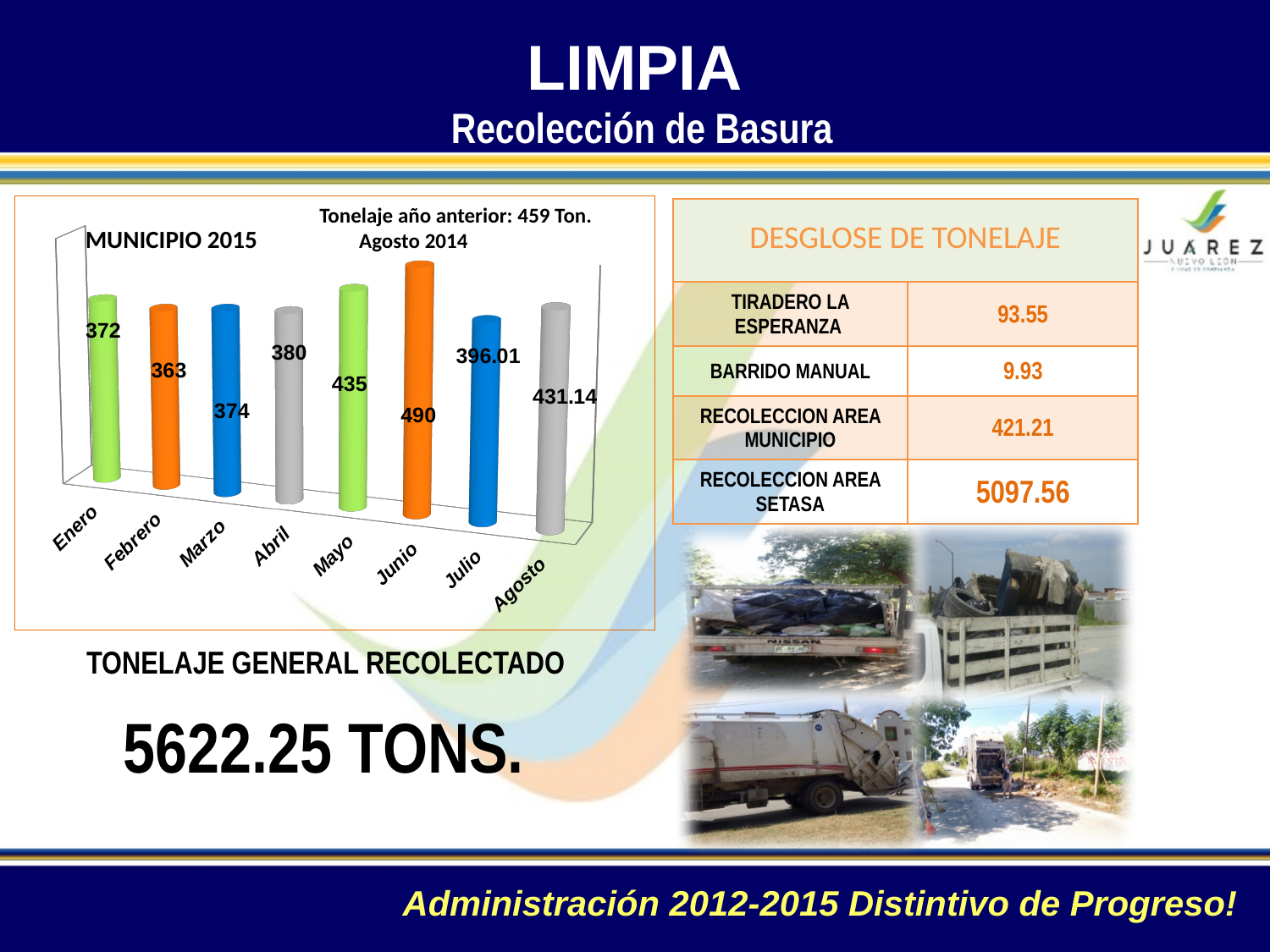
What is the value for Agosto in the MUNICIPIO 2015 chart? 431.14 According to the note on the chart, what was the tonnage for Agosto 2014? 459 Ton. What is the title of the chart on the slide? MUNICIPIO 2015 What is the value for Junio in the MUNICIPIO 2015 chart? 490 What is the value for Julio in the MUNICIPIO 2015 chart? 396.01 How many months are shown in the MUNICIPIO 2015 chart? 8 What kind of chart is the MUNICIPIO 2015 chart? bar chart Which month has the highest value in the MUNICIPIO 2015 chart? Junio Which is larger in the MUNICIPIO 2015 chart, the value for Mayo or the value for Agosto? Mayo What is the difference between the values for Mayo and Abril in the MUNICIPIO 2015 chart? 55 What is the difference between the values for Junio and Febrero in the MUNICIPIO 2015 chart? 127 Which month has the lowest value in the MUNICIPIO 2015 chart? Febrero